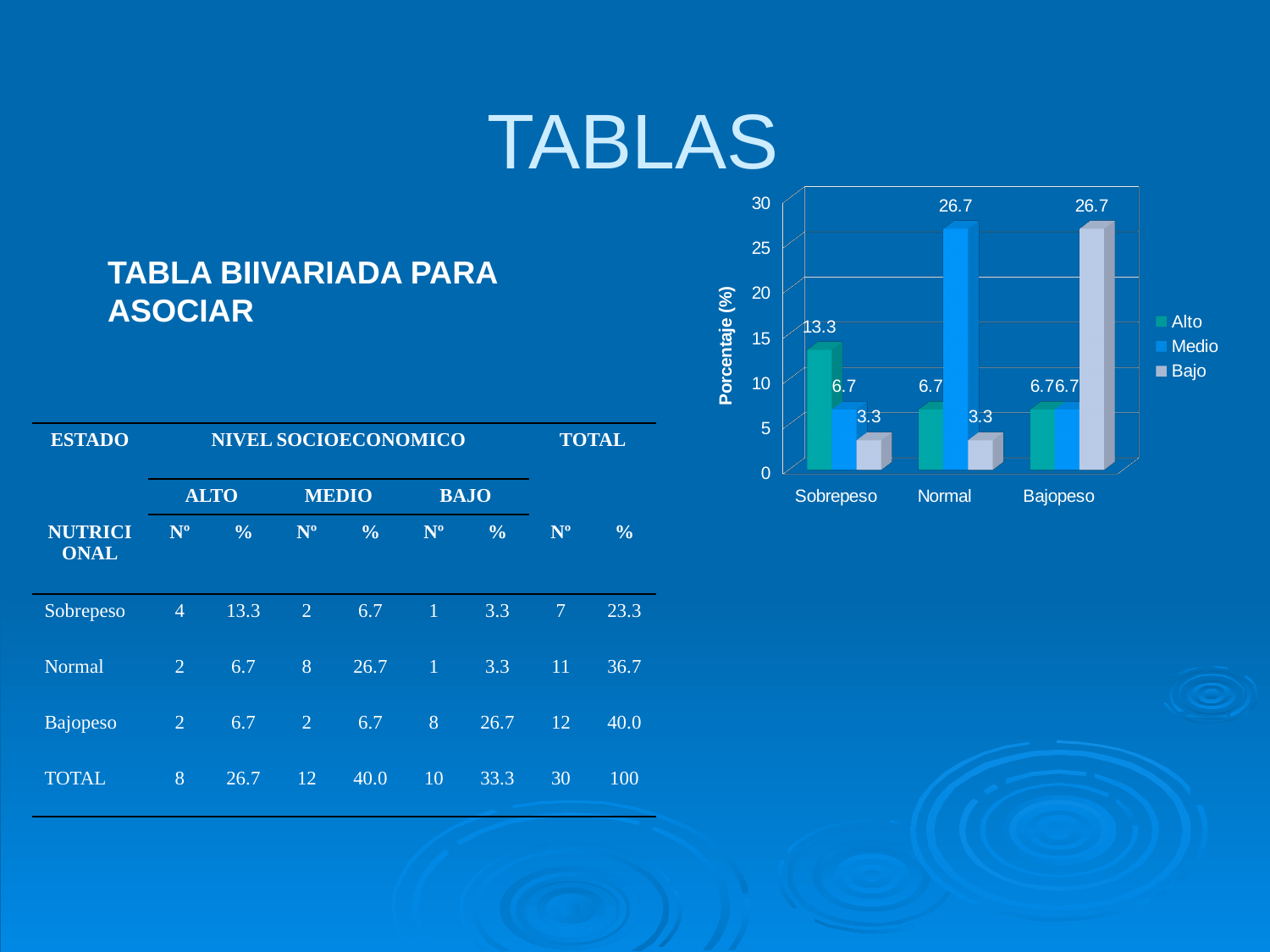
How many series does the legend list? 3 What is the value for Medio in the Normal category? 26.7 Which series has the highest value in the Sobrepeso category? Alto What is the value for Bajo in the Sobrepeso category? 3.3 How many categories are shown on the x axis? 3 Which is larger: the Alto value for Sobrepeso or the Alto value for Normal? Sobrepeso What is the label of the vertical axis? Porcentaje (%) Which series has the lowest value in the Normal category? Bajo What kind of chart is shown on the slide? Bar chart What is the difference between the Medio value for Normal and the Medio value for Sobrepeso? 20.0 What is the value for Bajo in the Bajopeso category? 26.7 What is the value for Alto in the Sobrepeso category? 13.3